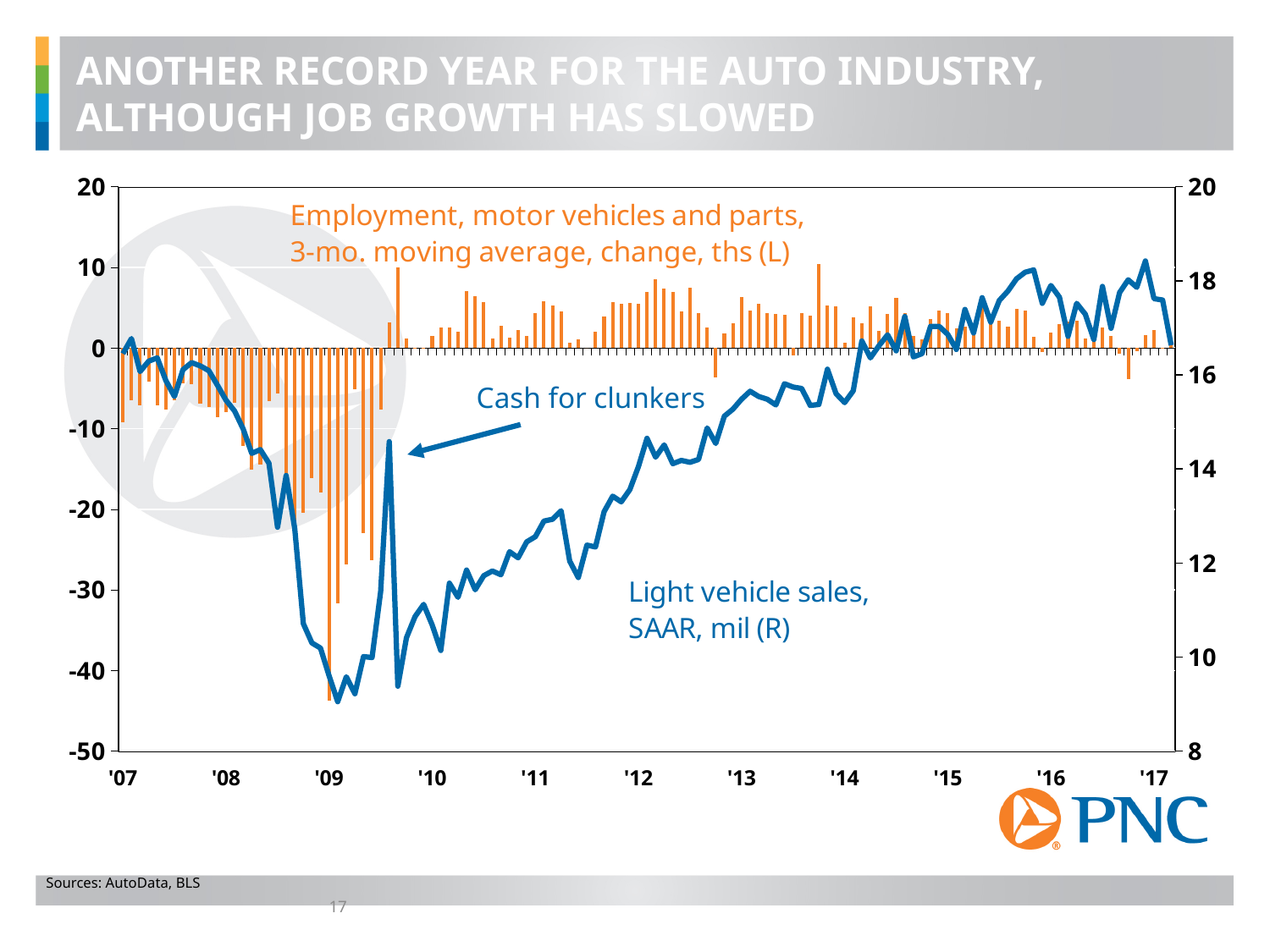
Around which year label does the light vehicle sales line reach its lowest point? '09 What kind of chart is shown on the slide? A combination bar and line chart Is the value of light vehicle sales at the start of '09 greater or less than 10? less Is the value of light vehicle sales at '16 greater or less than 16? greater Does the light vehicle sales line generally rise or fall between '09 and '16? rise How many data series are plotted on the chart? 2 Which series is plotted as orange bars? Employment, motor vehicles and parts, 3-mo. moving average, change, ths (L) Is the lowest employment bar, near '09, greater or less than -30? less Are light vehicle sales higher at '16 or at '09? '16 How many year labels are shown on the x axis? 11 Which series is plotted as the blue line? Light vehicle sales, SAAR, mil (R)